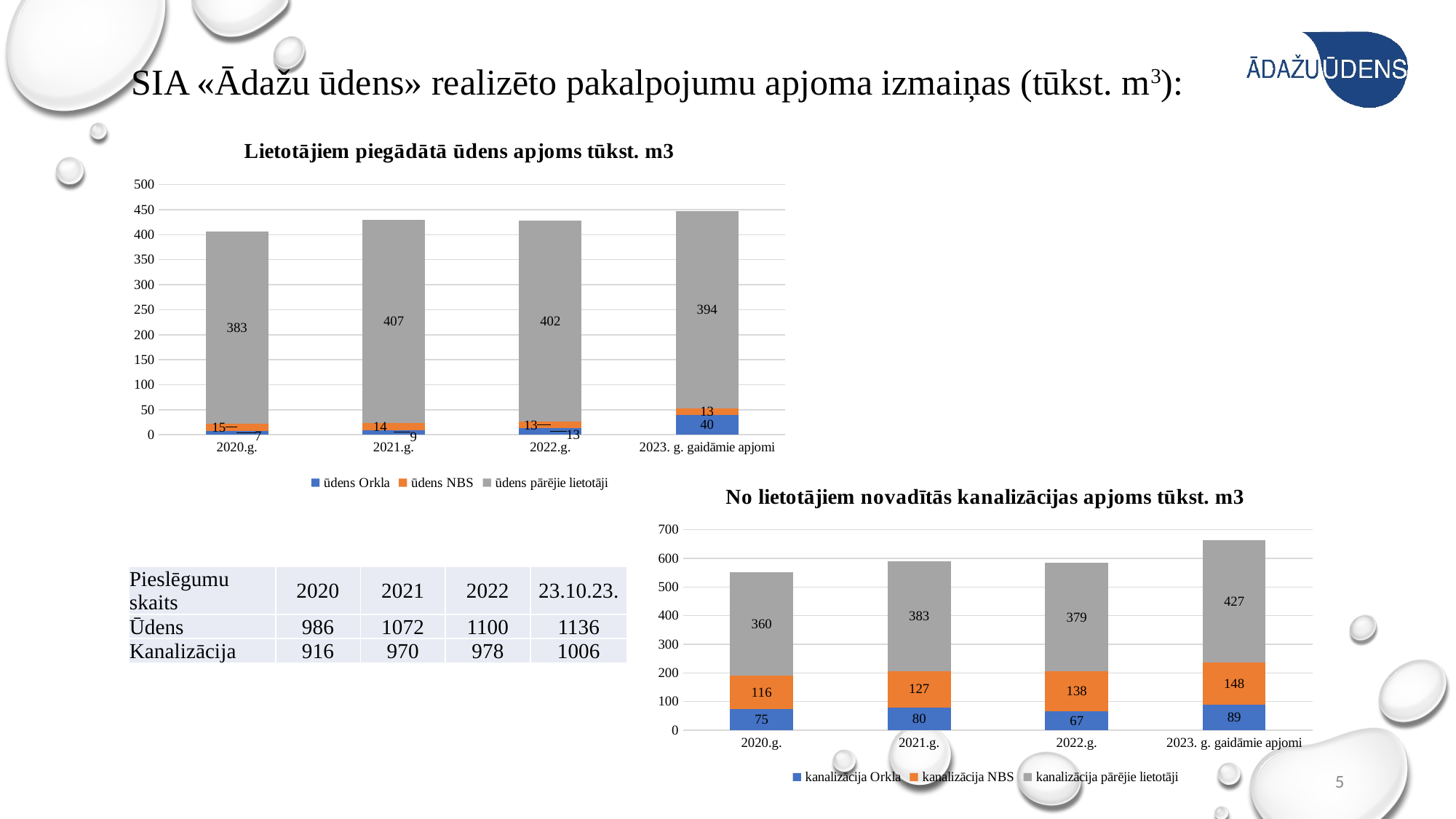
In the chart 'Lietotājiem piegādātā ūdens apjoms tūkst. m3', what is the value for ūdens pārējie lietotāji in 2021.g.? 407 In the chart 'No lietotājiem novadītās kanalizācijas apjoms tūkst. m3', is the total stacked bar for 2023. g. gaidāmie apjomi greater or less than 600? greater How many categories are shown on the x axis of the chart 'Lietotājiem piegādātā ūdens apjoms tūkst. m3'? 4 How many series does the legend of the chart 'No lietotājiem novadītās kanalizācijas apjoms tūkst. m3' list? 3 In the chart 'Lietotājiem piegādātā ūdens apjoms tūkst. m3', which is larger: ūdens pārējie lietotāji in 2020.g. or in 2022.g.? 2022.g. What kind of chart is 'No lietotājiem novadītās kanalizācijas apjoms tūkst. m3'? stacked bar chart In the chart 'No lietotājiem novadītās kanalizācijas apjoms tūkst. m3', what is the total of the stacked bar for 2020.g.? 551 In the chart 'No lietotājiem novadītās kanalizācijas apjoms tūkst. m3', what is the difference between kanalizācija NBS in 2023. g. gaidāmie apjomi and in 2020.g.? 32 In the chart 'Lietotājiem piegādātā ūdens apjoms tūkst. m3', what is the value for ūdens Orkla in 2023. g. gaidāmie apjomi? 40 In the chart 'No lietotājiem novadītās kanalizācijas apjoms tūkst. m3', what is the value for kanalizācija NBS in 2022.g.? 138 In the chart 'No lietotājiem novadītās kanalizācijas apjoms tūkst. m3', which year has the lowest value for kanalizācija Orkla? 2022.g. In the chart 'No lietotājiem novadītās kanalizācijas apjoms tūkst. m3', which year has the highest value for kanalizācija pārējie lietotāji? 2023. g. gaidāmie apjomi